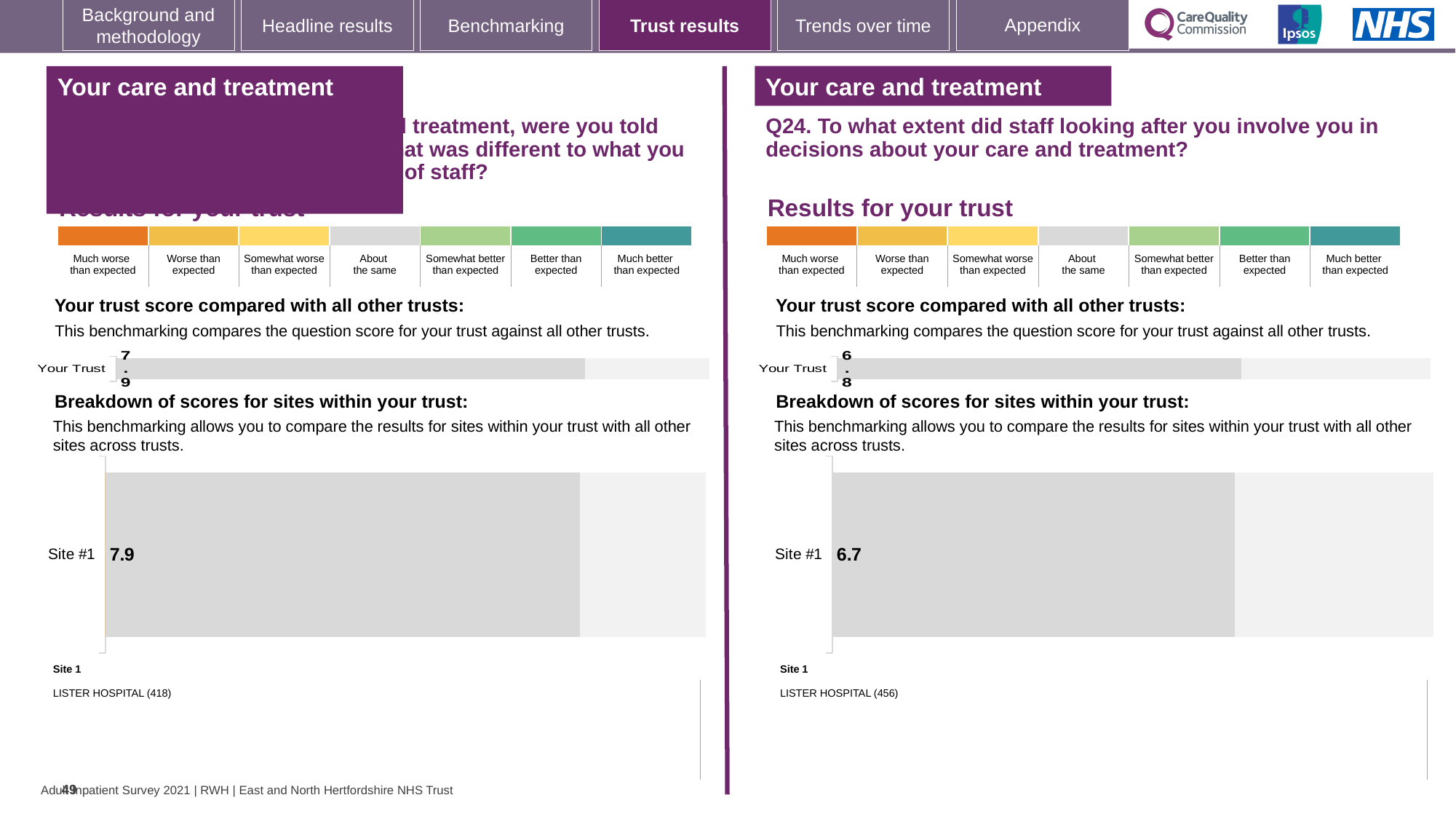
What is the difference between the Site #1 score in the left-hand site breakdown chart and the Site #1 score in the right-hand site breakdown chart? 1.2 Which hospital is listed as Site 1 beneath the left-hand site breakdown chart? LISTER HOSPITAL (418) On the left half of the slide, what is the value shown for Your Trust in the 'Your trust score compared with all other trusts' chart? 7.9 What is the difference between the Your Trust score on the left half of the slide and the Your Trust score on the right half of the slide? 1.1 What kind of chart is used to show the Site #1 score in the left-hand site breakdown? Bar chart On the right half of the slide, is the Your Trust score (6.8) greater or less than the Site #1 score (6.7)? greater On the right half of the slide (Q24), what is the value shown for Your Trust in the 'Your trust score compared with all other trusts' chart? 6.8 How many sites are plotted in the right-hand 'Breakdown of scores for sites within your trust' chart? 1 Which hospital is listed as Site 1 beneath the right-hand site breakdown chart? LISTER HOSPITAL (456) In the left-hand 'Breakdown of scores for sites within your trust' chart, what is the score for Site #1? 7.9 In the right-hand 'Breakdown of scores for sites within your trust' chart (Q24), what is the score for Site #1? 6.7 Which is larger: the Site #1 score in the left-hand site breakdown chart or the Site #1 score in the right-hand site breakdown chart? Left-hand chart (7.9)